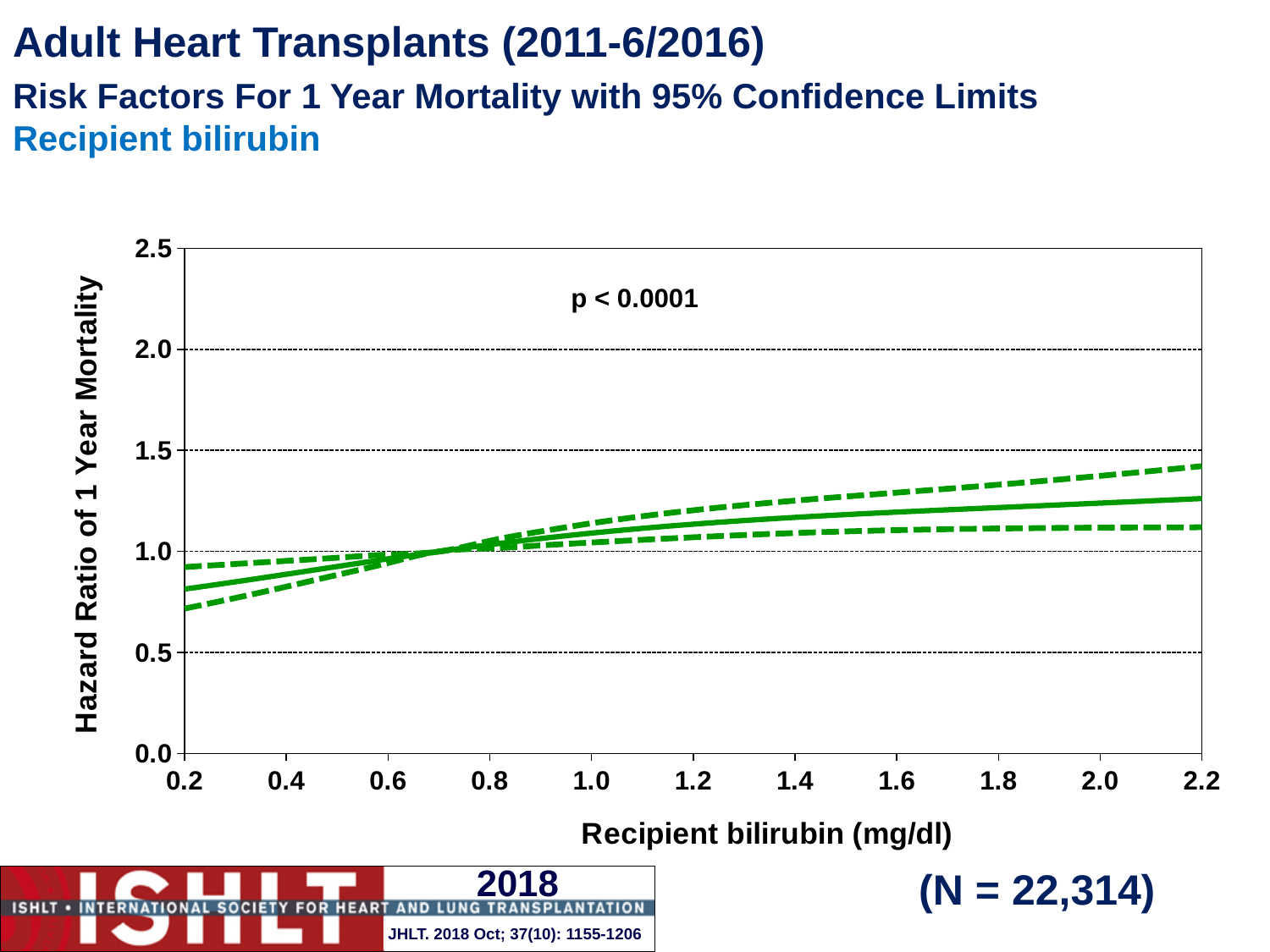
Is the hazard ratio (solid line) at a recipient bilirubin of 0.2 mg/dl greater or less than 1.0? less What p-value is printed on the chart? p < 0.0001 Is the hazard ratio (solid line) at a recipient bilirubin of 1.4 mg/dl greater or less than 1.5? less What kind of chart is shown on the slide? line chart What is the label of the x axis? Recipient bilirubin (mg/dl) Which is larger, the hazard ratio (solid line) at a recipient bilirubin of 0.4 mg/dl or at 1.8 mg/dl? 1.8 mg/dl How many lines are plotted on the chart? 3 Is the hazard ratio (solid line) at a recipient bilirubin of 2.2 mg/dl greater or less than 1.0? greater Does the hazard ratio of 1 year mortality rise or fall as recipient bilirubin increases from 0.2 to 2.2 mg/dl? rise